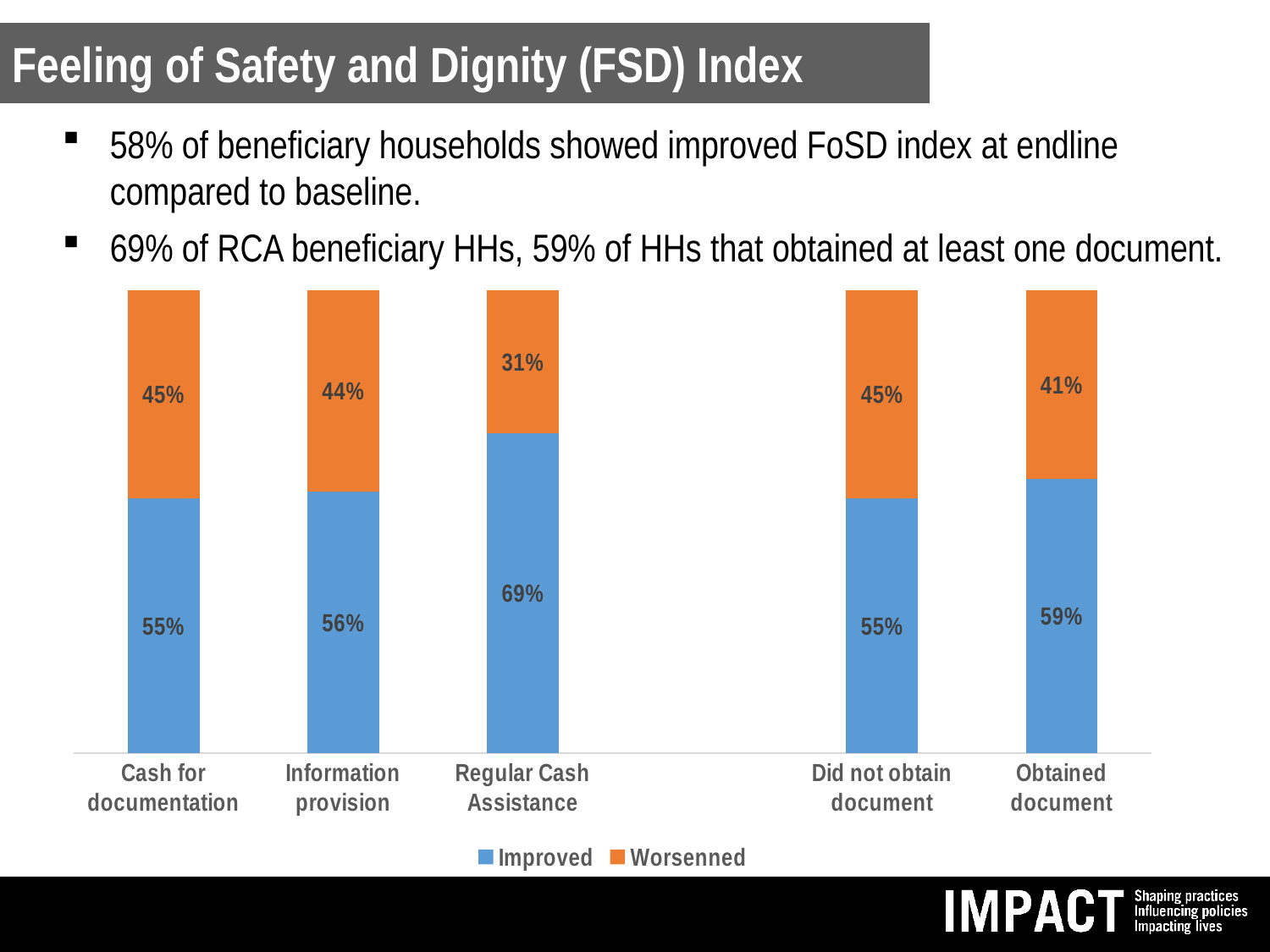
What is the difference between the Improved values for Regular Cash Assistance and Cash for documentation? 14% How many series does the legend list? 2 What kind of chart is shown on the slide? Stacked bar chart How many categories are shown on the x axis? 5 Which category has the highest Improved value? Regular Cash Assistance Which category has the lowest Worsenned value? Regular Cash Assistance What is the Worsenned value for Obtained document? 41% What is the total of the stacked bar for Information provision? 100% Which is larger, the Improved value for Obtained document or for Did not obtain document? Obtained document What is the Worsenned value for Cash for documentation? 45% What is the Improved value for Information provision? 56% What is the Improved value for Regular Cash Assistance? 69%